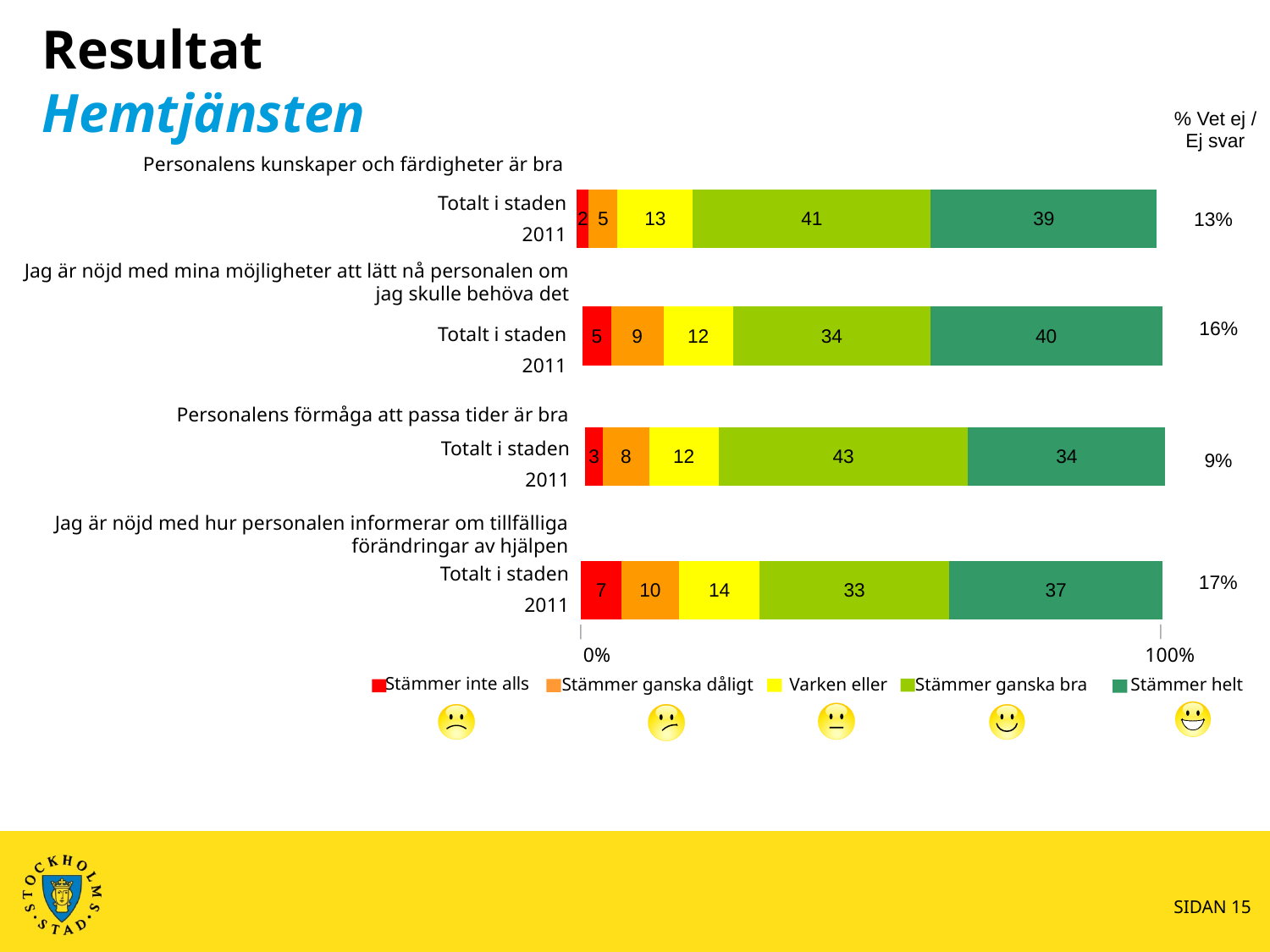
What kind of chart is shown on the slide? Stacked bar chart Which is larger: the 'Varken eller' value for 'Personalens kunskaper och färdigheter är bra' or for 'Jag är nöjd med hur personalen informerar om tillfälliga förändringar av hjälpen'? Jag är nöjd med hur personalen informerar om tillfälliga förändringar av hjälpen What is the value of 'Stämmer inte alls' for 'Jag är nöjd med hur personalen informerar om tillfälliga förändringar av hjälpen'? 7 What is the '% Vet ej / Ej svar' value shown for 'Personalens förmåga att passa tider är bra'? 9% How many bars are plotted in the chart? 4 What is the value of 'Stämmer ganska bra' for 'Personalens förmåga att passa tider är bra'? 43 Which statement has the highest 'Stämmer helt' value? Jag är nöjd med mina möjligheter att lätt nå personalen om jag skulle behöva det What is the total of the stacked bar for 'Jag är nöjd med mina möjligheter att lätt nå personalen om jag skulle behöva det'? 100 How many series does the legend list? 5 What is the value of 'Stämmer helt' for 'Personalens kunskaper och färdigheter är bra'? 39 Which statement has the lowest 'Stämmer inte alls' value? Personalens kunskaper och färdigheter är bra What is the difference between the 'Stämmer ganska bra' values for 'Personalens förmåga att passa tider är bra' and 'Jag är nöjd med hur personalen informerar om tillfälliga förändringar av hjälpen'? 10